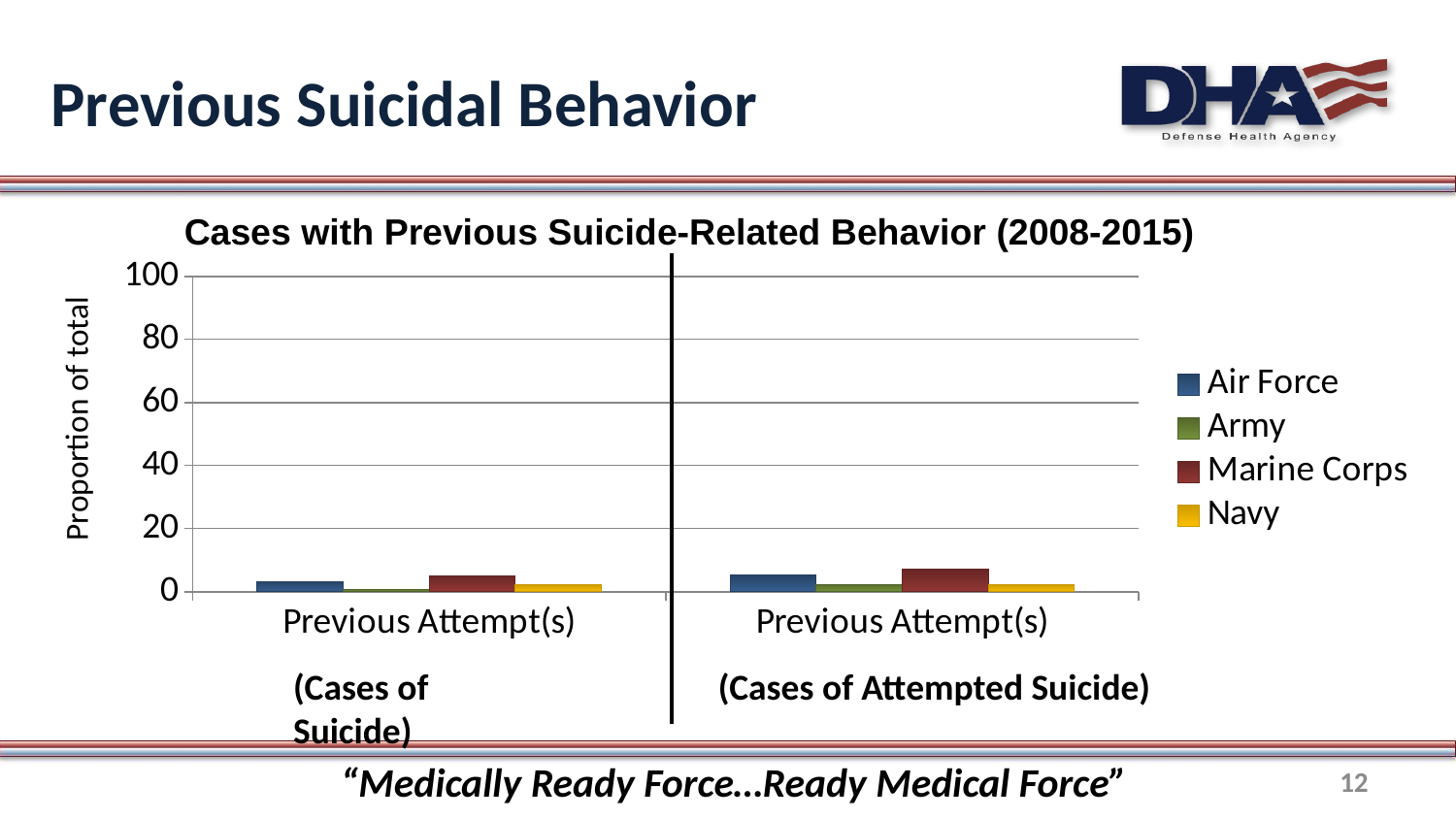
What type of chart is shown on the slide? bar chart What is the label on the vertical axis? Proportion of total How many category groups are plotted along the x axis? 2 Which service has the highest bar in the Cases of Suicide group? Marine Corps Is the value for Air Force in the Cases of Suicide group greater or less than 20? less Which service has the highest bar in the Cases of Attempted Suicide group? Marine Corps How many series does the legend list? 4 In the Cases of Suicide group, which is larger: the Marine Corps bar or the Army bar? Marine Corps Which service has the lowest bar in the Cases of Suicide group? Army In the Cases of Attempted Suicide group, which is larger: the Air Force bar or the Army bar? Air Force What is the title of the chart? Cases with Previous Suicide-Related Behavior (2008-2015) Is the value for Marine Corps in the Cases of Attempted Suicide group greater or less than 20? less